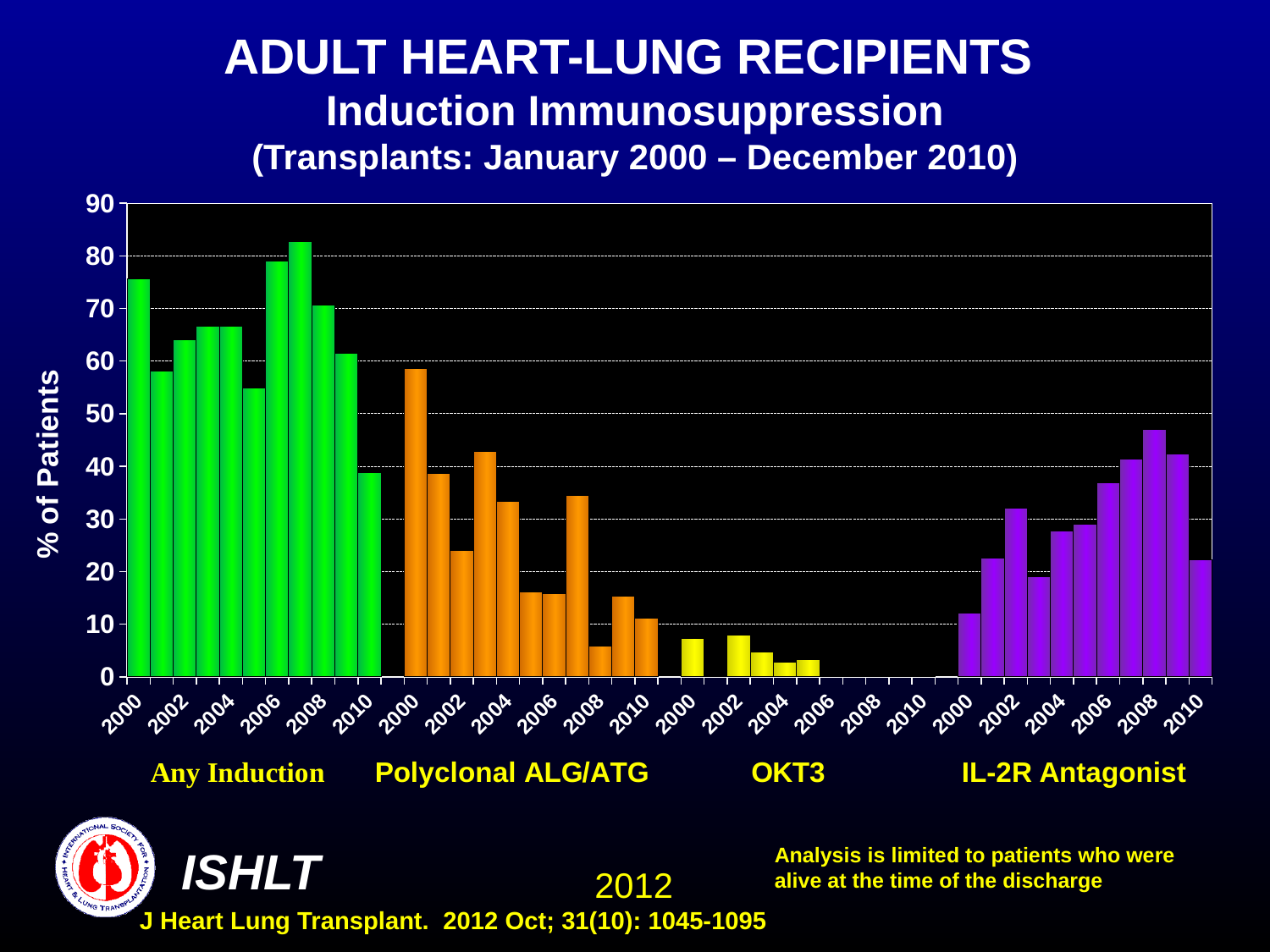
In the IL-2R Antagonist group, which year has the highest percentage of patients? 2008 Which induction group is plotted in yellow bars? OKT3 In the Polyclonal ALG/ATG group, which year has the lowest percentage of patients? 2008 For 2008, which is larger: the IL-2R Antagonist value or the Polyclonal ALG/ATG value? IL-2R Antagonist Is the Polyclonal ALG/ATG value for 2000 greater or less than 50? greater In the Any Induction group, which year has the highest percentage of patients? 2007 What is the label of the y axis? % of Patients In the Polyclonal ALG/ATG group, which year has the highest percentage of patients? 2000 Is the Any Induction value for 2000 greater or less than 70? greater In the Any Induction group, which year has the lowest percentage of patients? 2010 How many induction agent groups are shown along the x axis of the chart? 4 What kind of chart is shown on the slide? Bar chart